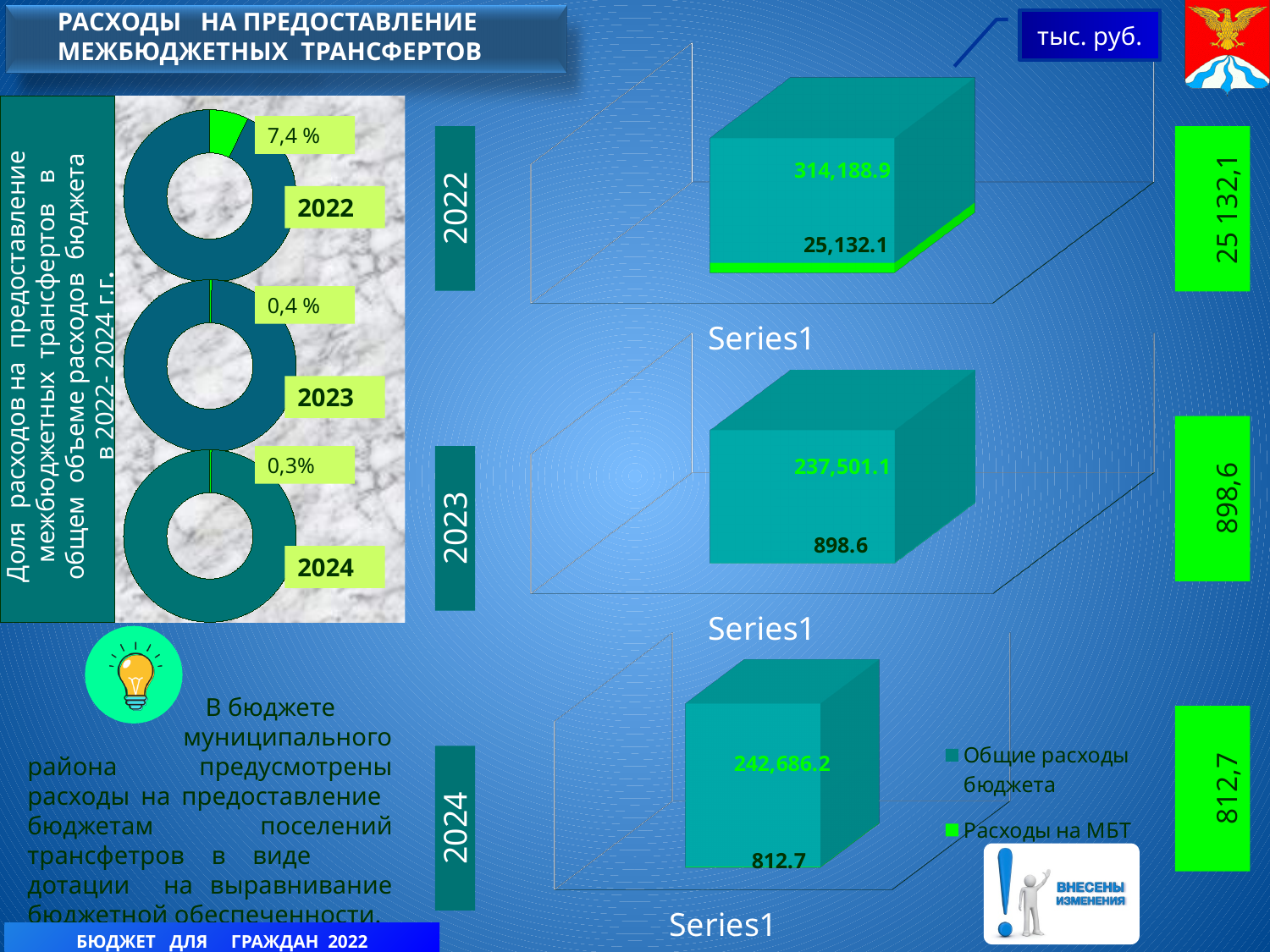
In the 2022 bar chart, what is the value labelled for expenses on MBT (Расходы на МБТ)? 25,132.1 In the 2024 bar chart, what is the value labelled for total budget expenses? 242,686.2 Which year's bar chart shows the larger value for expenses on MBT, 2023 or 2024? 2023 In the 2024 bar chart, what is the value labelled for expenses on MBT? 812.7 In the 2023 donut chart on the left, what share is shown for the green slice? 0,4 % How many series does the legend of the bar charts list? 2 In the 2022 donut chart on the left, what share is shown for the green slice? 7,4 % In the 2023 bar chart, what is the value labelled for total budget expenses? 237,501.1 In the 2022 bar chart, what is the value labelled for total budget expenses (Общие расходы бюджета)? 314,188.9 In the 2024 donut chart on the left, what share is shown for the green slice? 0,3% What type of chart is used for the 2022, 2023 and 2024 charts in the centre of the slide? Bar chart In the 2023 bar chart, what is the value labelled for expenses on MBT? 898.6